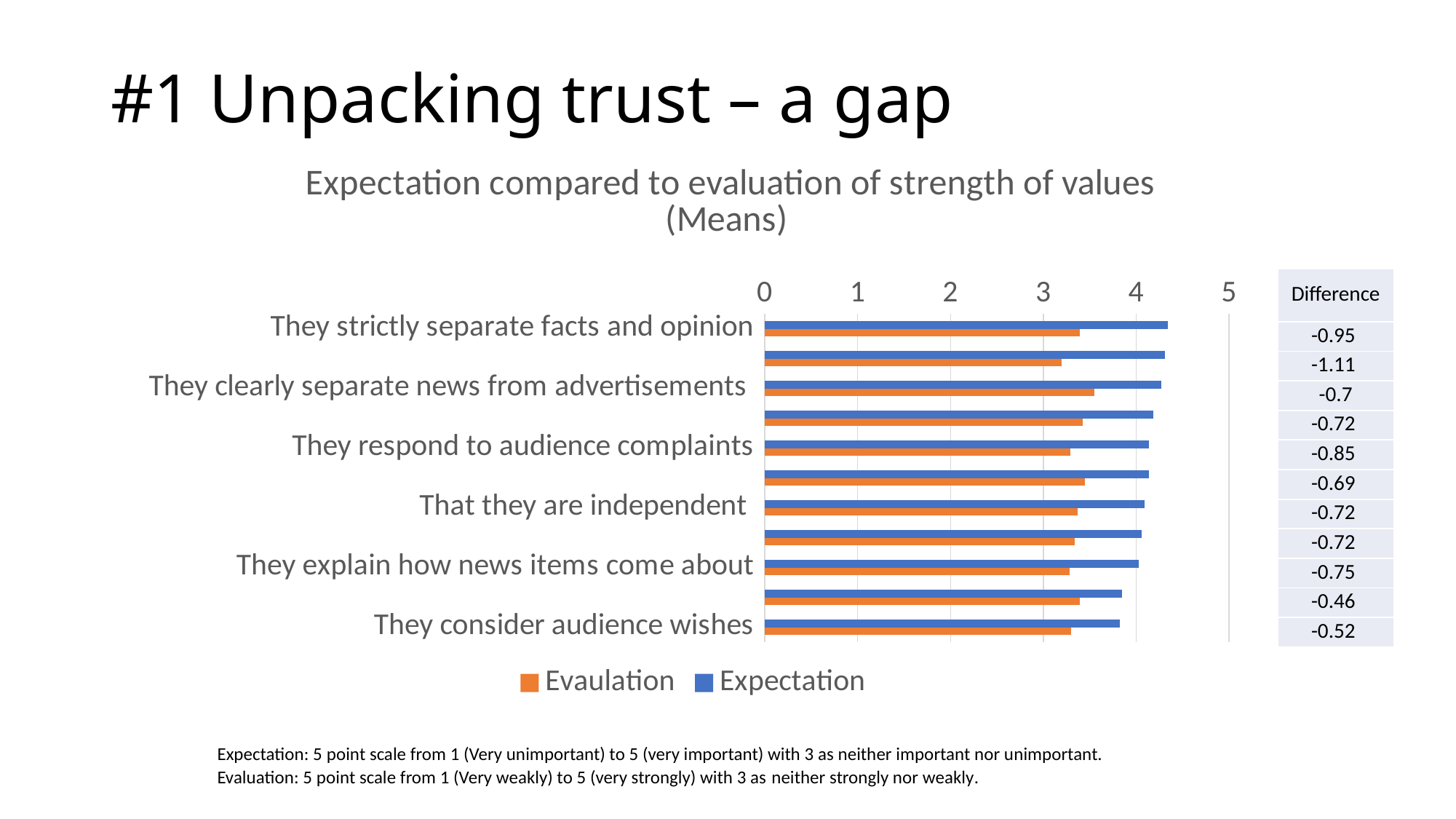
Among the labelled categories, which has the lowest Expectation value? They consider audience wishes What kind of chart is shown on the slide? bar chart How many series does the chart's legend list? 2 Is the Evaulation value for "They strictly separate facts and opinion" greater or less than 4? less Which series is shown in orange in the chart? Evaulation Is the Expectation value for "They strictly separate facts and opinion" greater or less than 4? greater Is the Evaulation value for "They consider audience wishes" greater or less than 3? greater According to the Difference column next to the chart, what is the difference for "They strictly separate facts and opinion"? -0.95 For "They respond to audience complaints", which is larger: the Expectation value or the Evaulation value? Expectation What is the title of the chart? Expectation compared to evaluation of strength of values (Means)